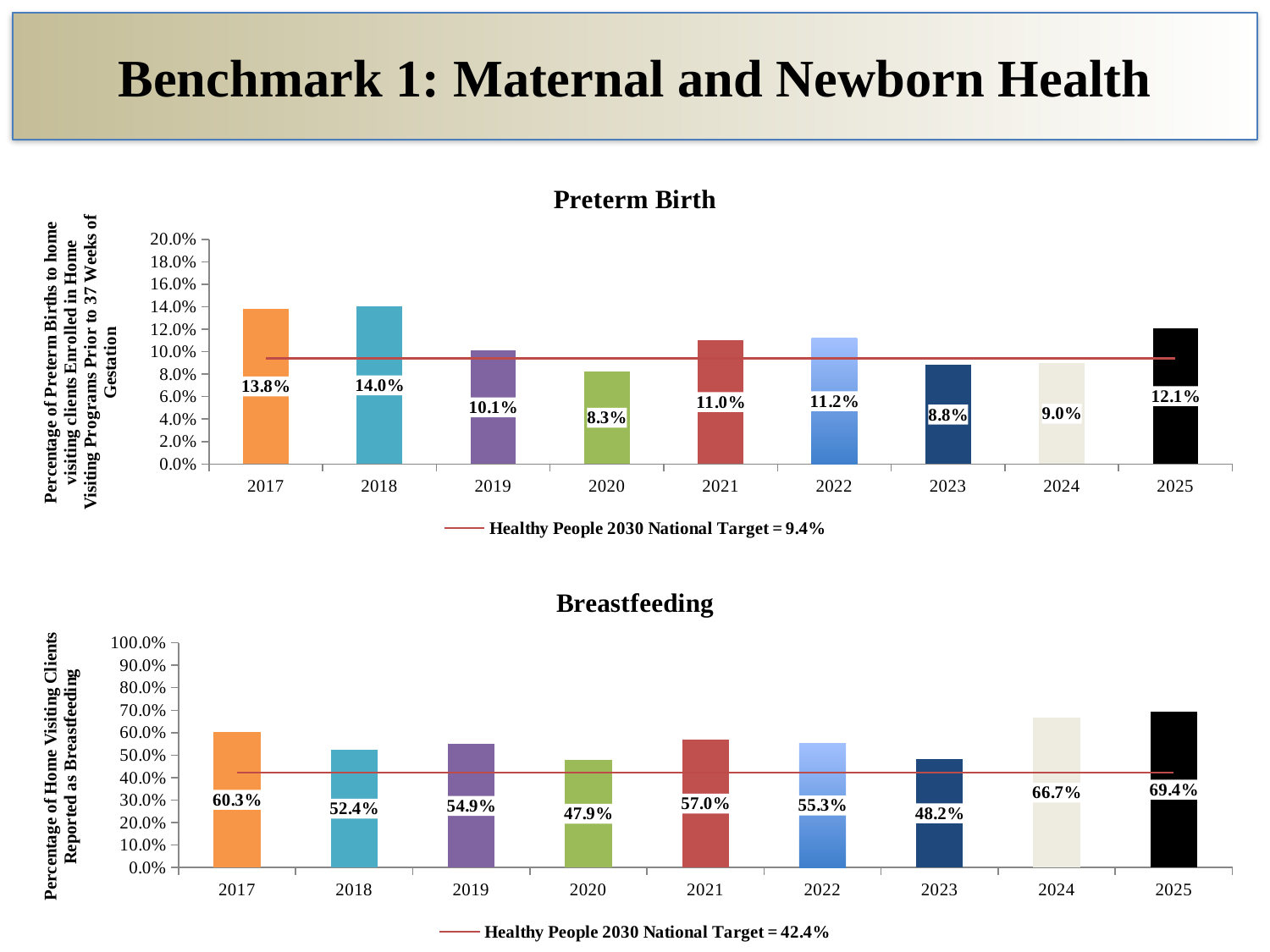
In the Breastfeeding chart, what is the difference between the 2017 value and the 2018 value? 7.9% In the Breastfeeding chart, is the value for 2023 greater or less than 50.0%? less In the Preterm Birth chart, what is the difference between the 2025 value and the 2024 value? 3.1% In the Preterm Birth chart, which year has the highest value? 2018 In the Preterm Birth chart, which is larger, the value for 2021 or the value for 2022? 2022 In the Preterm Birth chart, what is the value for 2020? 8.3% In the Breastfeeding chart, what is the value for 2024? 66.7% What is the Healthy People 2030 National Target shown in the legend of the Breastfeeding chart? 42.4% How many years are shown on the x axis of the Breastfeeding chart? 9 What kind of chart is the Preterm Birth chart? bar chart In the Breastfeeding chart, which year has the highest value? 2025 In the Breastfeeding chart, which year has the lowest value? 2020